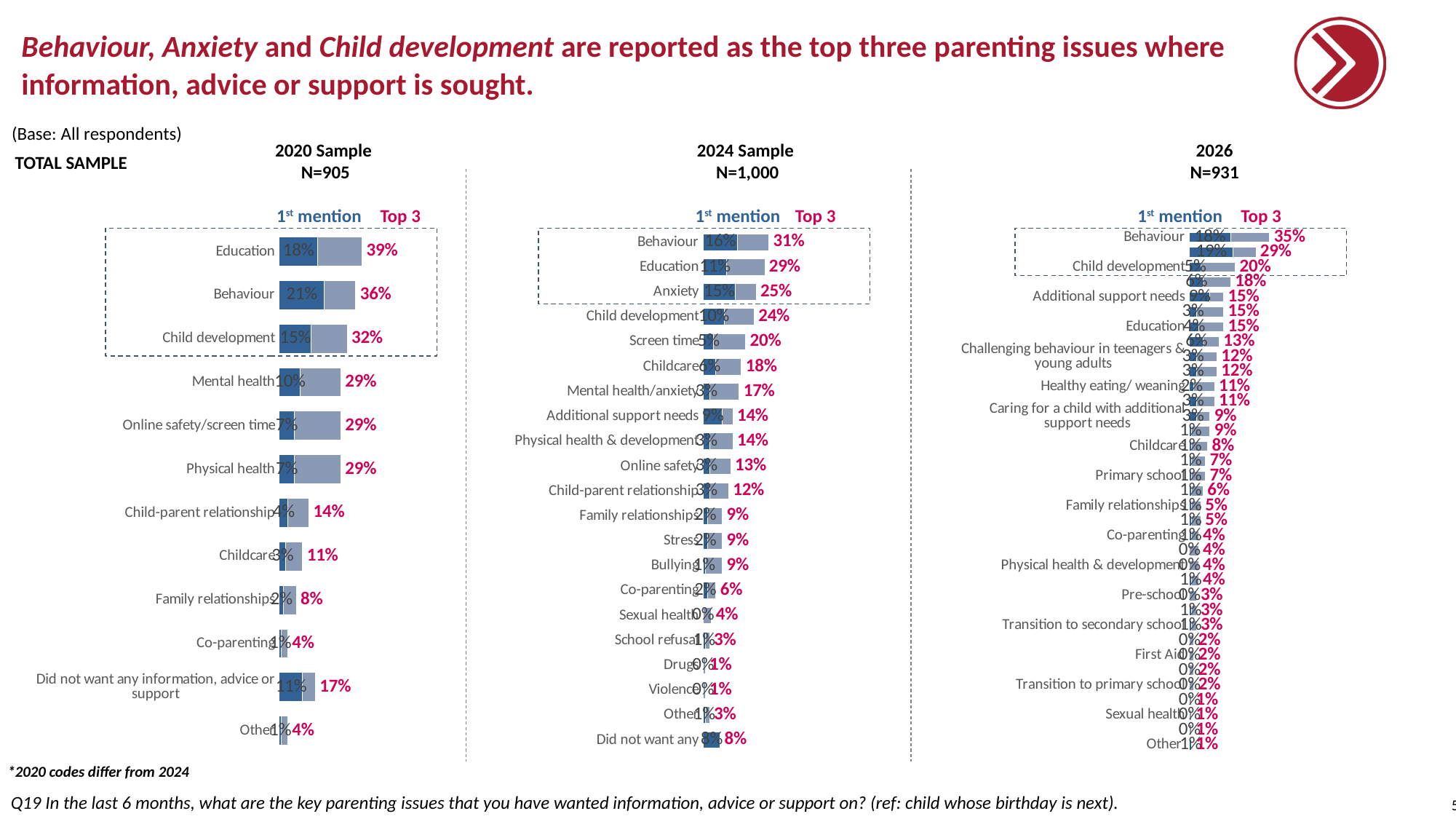
In the 2020 Sample chart, what is the difference between the Top 3 values for Education and Child development? 7% In the 2024 Sample chart, what is the Top 3 value for Anxiety? 25% In the 2026 chart, what is the Top 3 value for Behaviour? 35% How many categories are shown in the 2020 Sample chart? 12 In the 2020 Sample chart, what is the Top 3 value for Education? 39% In the 2024 Sample chart, which has a larger Top 3 value: Screen time or Childcare? Screen time In the 2020 Sample chart, what is the 1st mention value for Behaviour? 21% In the 2020 Sample chart, which category has the highest Top 3 value? Education In the 2026 chart, what is the Top 3 value for Child development? 20% What type of chart is used for the 2024 Sample? Bar chart In the 2024 Sample chart, what is the 1st mention value for Additional support needs? 9% In the 2024 Sample chart, which category has the highest Top 3 value? Behaviour